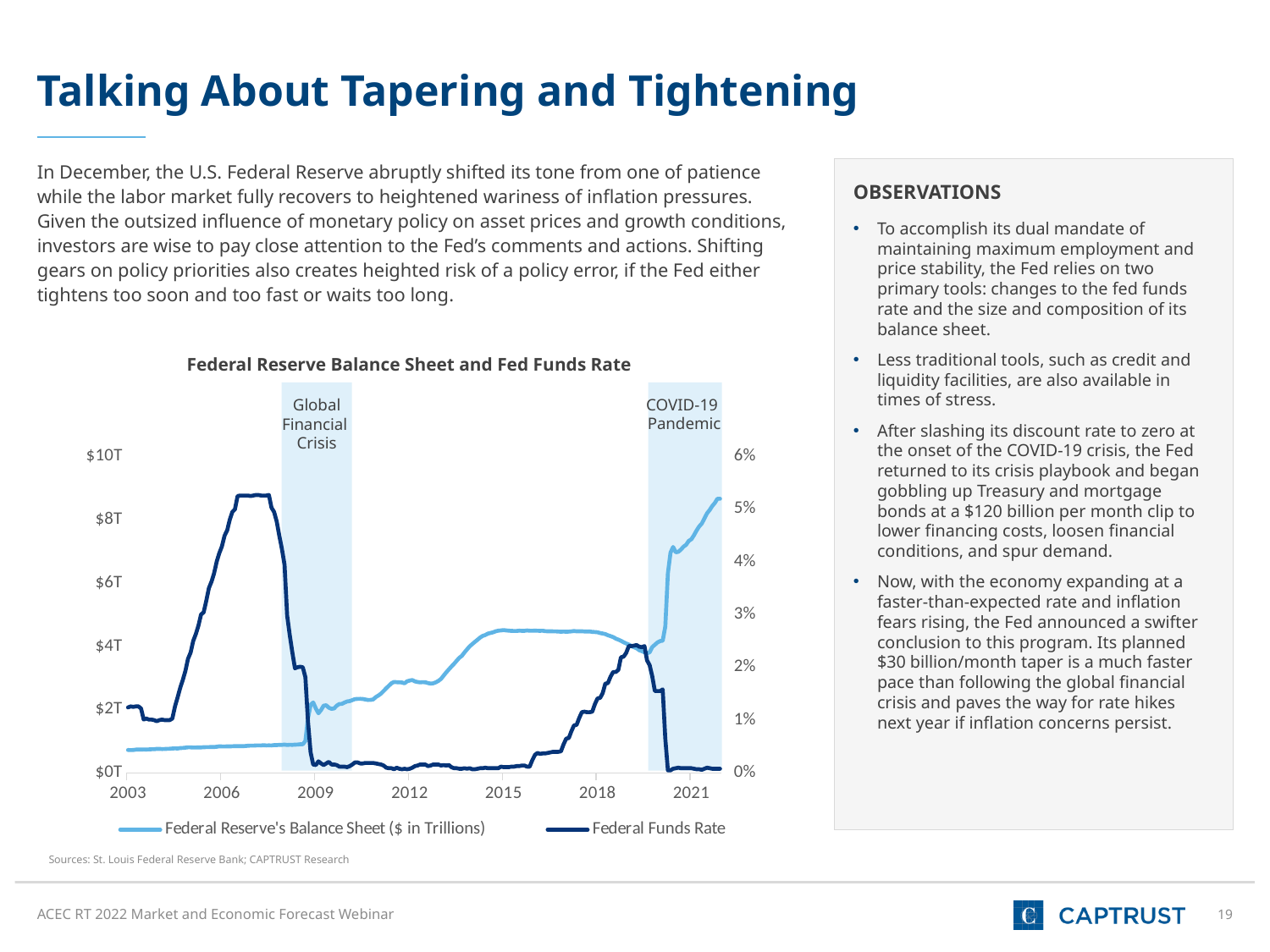
What kind of chart is shown on the slide? Line chart Which two events are marked by shaded regions on the chart? Global Financial Crisis and COVID-19 Pandemic How many series does the chart's legend list? 2 Does the Federal Funds Rate rise or fall between 2007 and 2009? Fall Is the Federal Reserve's Balance Sheet value in 2003 greater or less than $2T? less Is the Federal Funds Rate in 2007 greater or less than 4%? greater Is the Federal Reserve's Balance Sheet value at the end of 2021 greater or less than $8T? greater What is the title of the chart? Federal Reserve Balance Sheet and Fed Funds Rate Does the Federal Reserve's Balance Sheet series generally rise or fall from 2003 to 2021? Rise How many year labels are shown on the x axis? 7